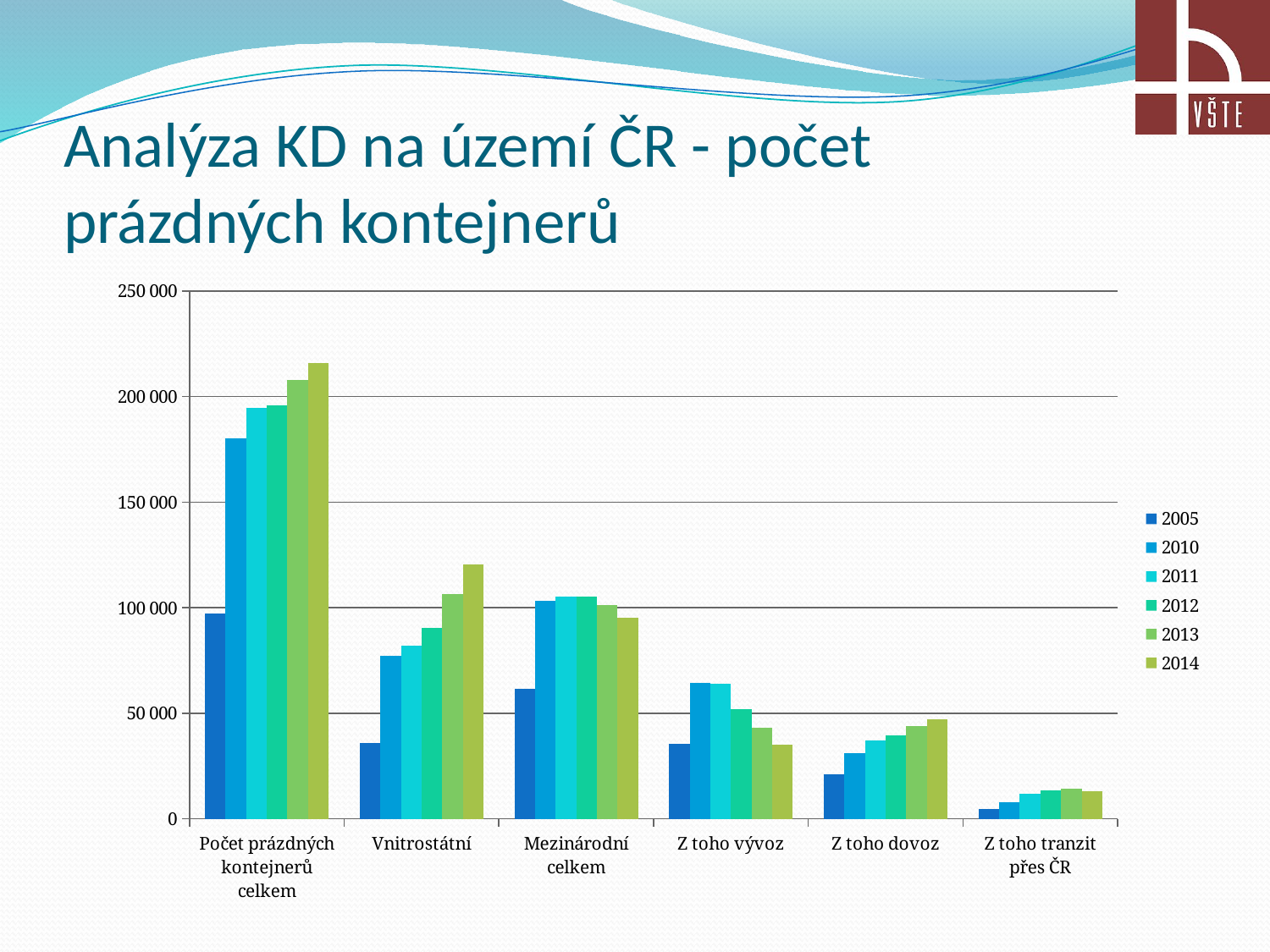
Which year has the lowest value in the 'Vnitrostátní' category? 2005 Which years are listed in the chart legend? 2005, 2010, 2011, 2012, 2013, 2014 Which year has the highest value in the 'Počet prázdných kontejnerů celkem' category? 2014 Do the values for 'Z toho dovoz' rise or fall from 2005 to 2014? rise How many categories are shown on the x axis of the chart? 6 Is the 2005 value for 'Počet prázdných kontejnerů celkem' greater or less than 100 000? less Is the 2014 value for 'Z toho vývoz' greater or less than 50 000? less What kind of chart is shown on the slide? bar chart For 2014, which is larger: 'Vnitrostátní' or 'Mezinárodní celkem'? Vnitrostátní Is the 2014 value for 'Počet prázdných kontejnerů celkem' greater or less than 200 000? greater How many series does the legend list? 6